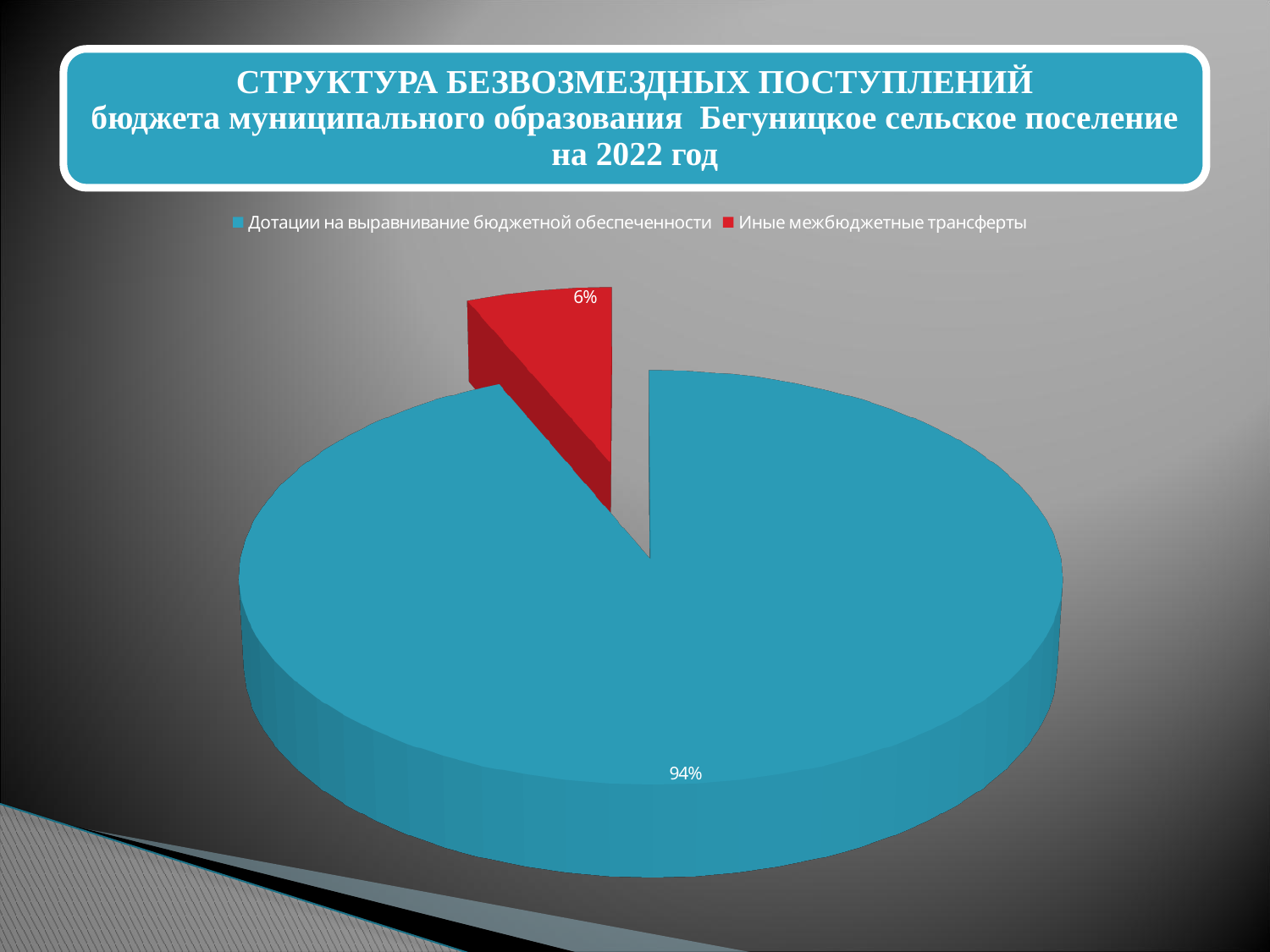
What share of the pie does "Иные межбюджетные трансферты" represent? 6% What kind of chart is shown on the slide? pie chart Which category has the smallest slice of the pie? Иные межбюджетные трансферты Which category has the largest slice of the pie? Дотации на выравнивание бюджетной обеспеченности How many slices does the pie chart have? 2 How many entries does the legend list? 2 What is the difference in percentage points between the "Дотации на выравнивание бюджетной обеспеченности" slice and the "Иные межбюджетные трансферты" slice? 88 What colour is the slice for "Иные межбюджетные трансферты"? red What year does the chart title refer to? 2022 Which is larger: the slice for "Дотации на выравнивание бюджетной обеспеченности" or the slice for "Иные межбюджетные трансферты"? Дотации на выравнивание бюджетной обеспеченности What share of the pie does "Дотации на выравнивание бюджетной обеспеченности" represent? 94%